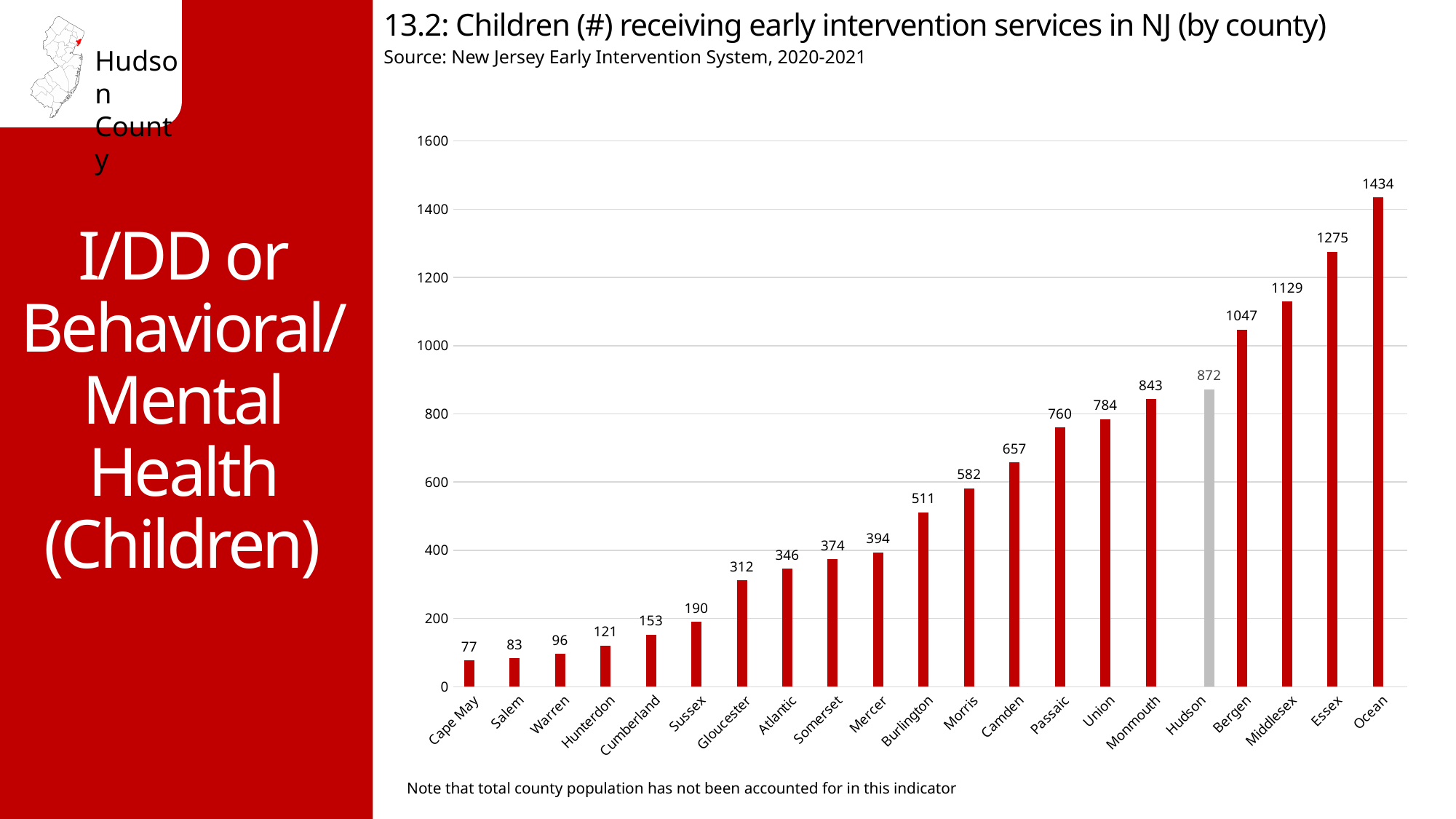
Do the values rise or fall moving from left to right along the x axis? Rise Which county's bar is coloured grey instead of red? Hudson How many children are receiving early intervention services in Hudson County? 872 Which county has the highest number of children receiving early intervention services? Ocean What is the difference between the values for Essex and Hudson? 403 Which county has the lowest number of children receiving early intervention services? Cape May Is the value for Camden greater or less than 600? greater What is the value shown for Cape May? 77 What kind of chart is shown on the slide? Bar chart Which county has a larger value, Bergen or Monmouth? Bergen What is the value shown for Ocean County? 1434 How many counties are shown on the chart? 21